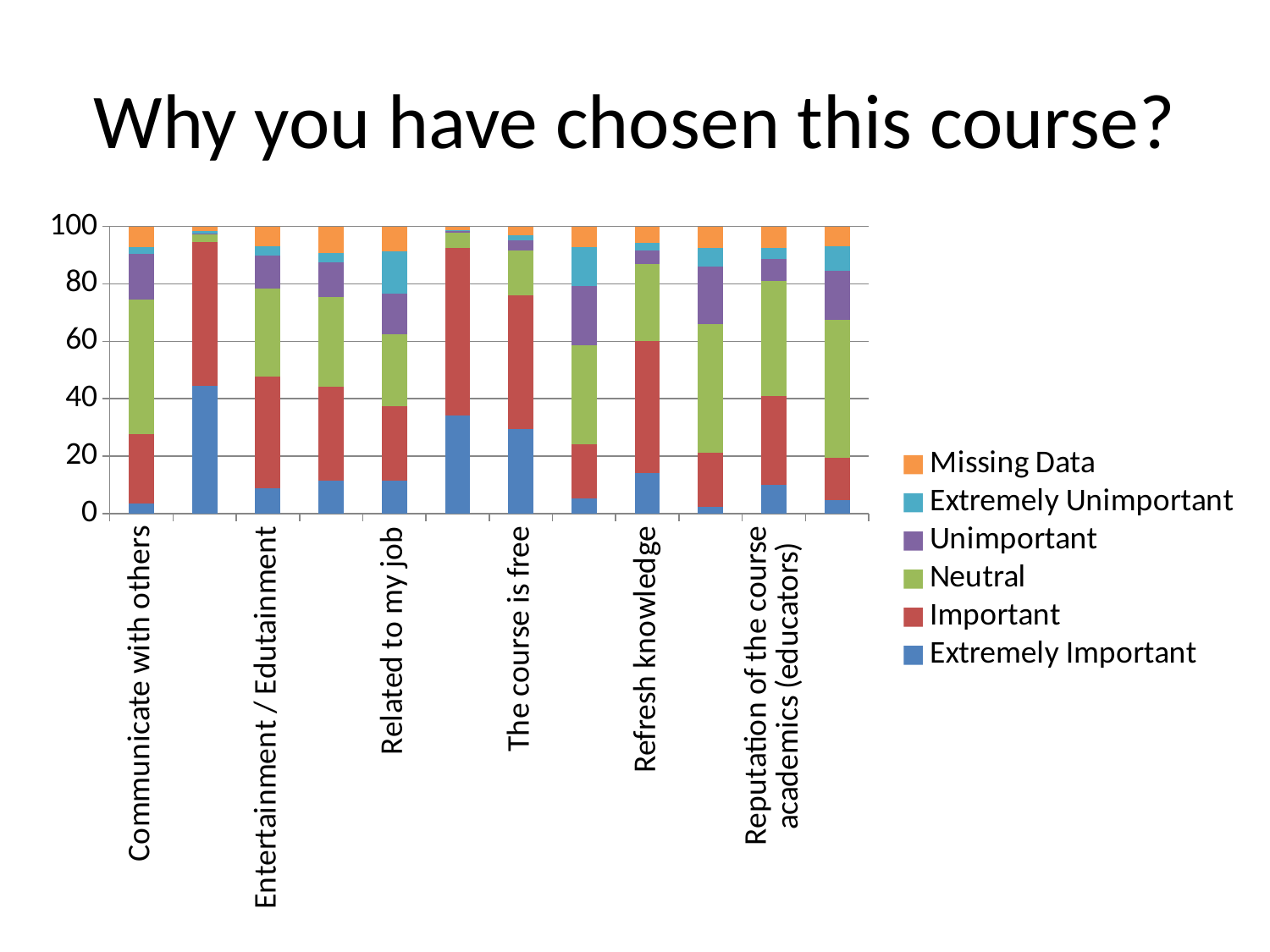
Which has the larger Neutral segment: Refresh knowledge or The course is free? Refresh knowledge Is the Extremely Important value for Related to my job greater or less than 20? less What is the title of the chart? Why you have chosen this course? Is the Extremely Important value for The course is free greater or less than 20? greater What kind of chart is shown on the slide? Stacked bar chart Among the labelled categories, which has the largest Extremely Important segment? The course is free Among the labelled categories, which has the smallest Extremely Important segment? Communicate with others Which legend entry is listed first (at the top) in the legend? Missing Data Is the Extremely Important value for Reputation of the course academics (educators) greater or less than 20? less Which has the larger Extremely Important segment: The course is free or Communicate with others? The course is free How many series does the legend list? 6